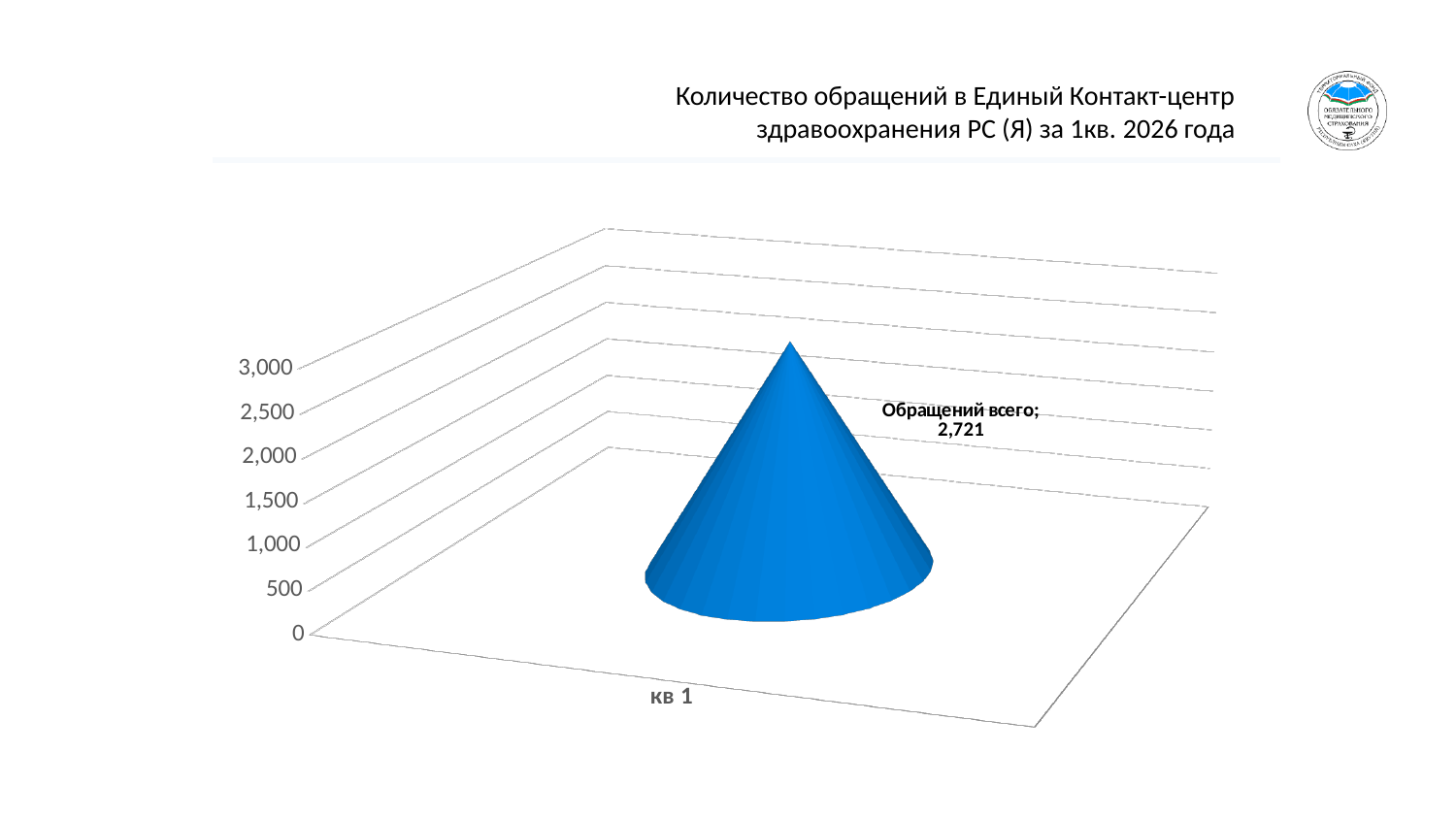
How many categories are shown on the x axis of the chart? 1 What is the label of the only category on the x axis? кв 1 What is the highest tick value shown on the vertical axis? 3,000 What is the value of Обращений всего for кв 1? 2,721 What kind of chart is shown on the slide? bar chart Is the value for кв 1 greater or less than 2,500? greater What is the name of the data series shown in the data label? Обращений всего Is the value for кв 1 greater or less than 3,000? less